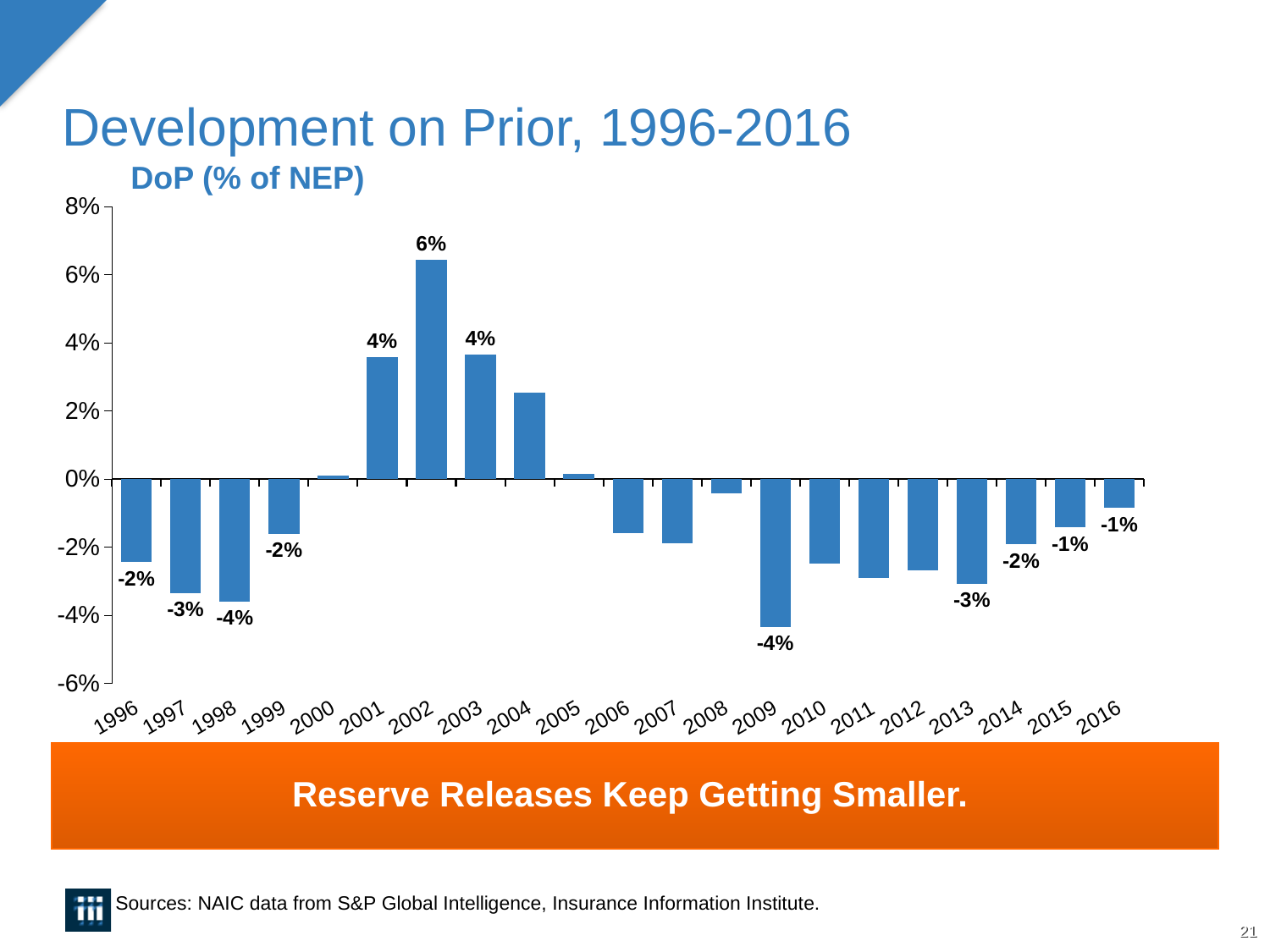
What kind of chart is this? Bar chart What is the value for 1998? -4% Do the values rise or fall from 2013 to 2016? Rise Which is larger, the value for 2001 or the value for 2002? 2002 Which year has the highest value? 2002 What is the value for 2016? -1% Is the value for 2011 greater or less than -2%? less How many years are shown on the x axis? 21 Is the value for 2004 greater or less than 2%? greater What is the difference between the values for 2002 and 2003? 2 percentage points What is the value for 2002? 6% What is the title shown above the chart's y axis? DoP (% of NEP)